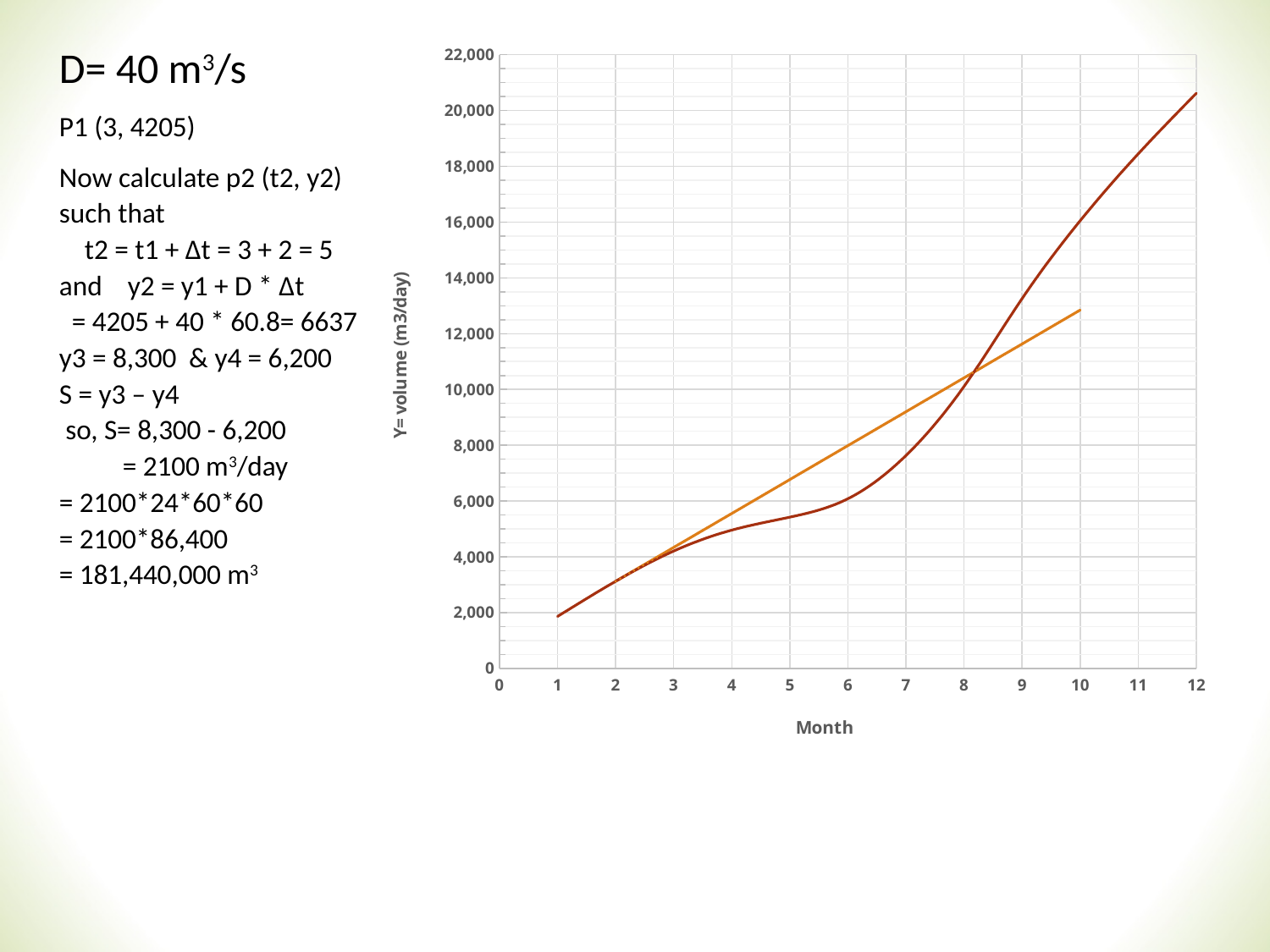
Does the dark red curve rise or fall as the month increases? rise Is the value of the dark red curve at month 12 greater or less than 20,000? greater How many lines are plotted on the chart? 2 What is the title of the y axis of the chart? Y= volume (m3/day) What kind of chart is shown on the slide? line chart Is the value of the orange straight line at month 8 greater or less than 10,000? greater At month 10, which line has the higher value, the dark red curve or the orange straight line? the dark red curve Is the value of the dark red curve at month 4 greater or less than 4,000? greater At month 5, which line has the higher value, the dark red curve or the orange straight line? the orange straight line What is the title of the x axis of the chart? Month